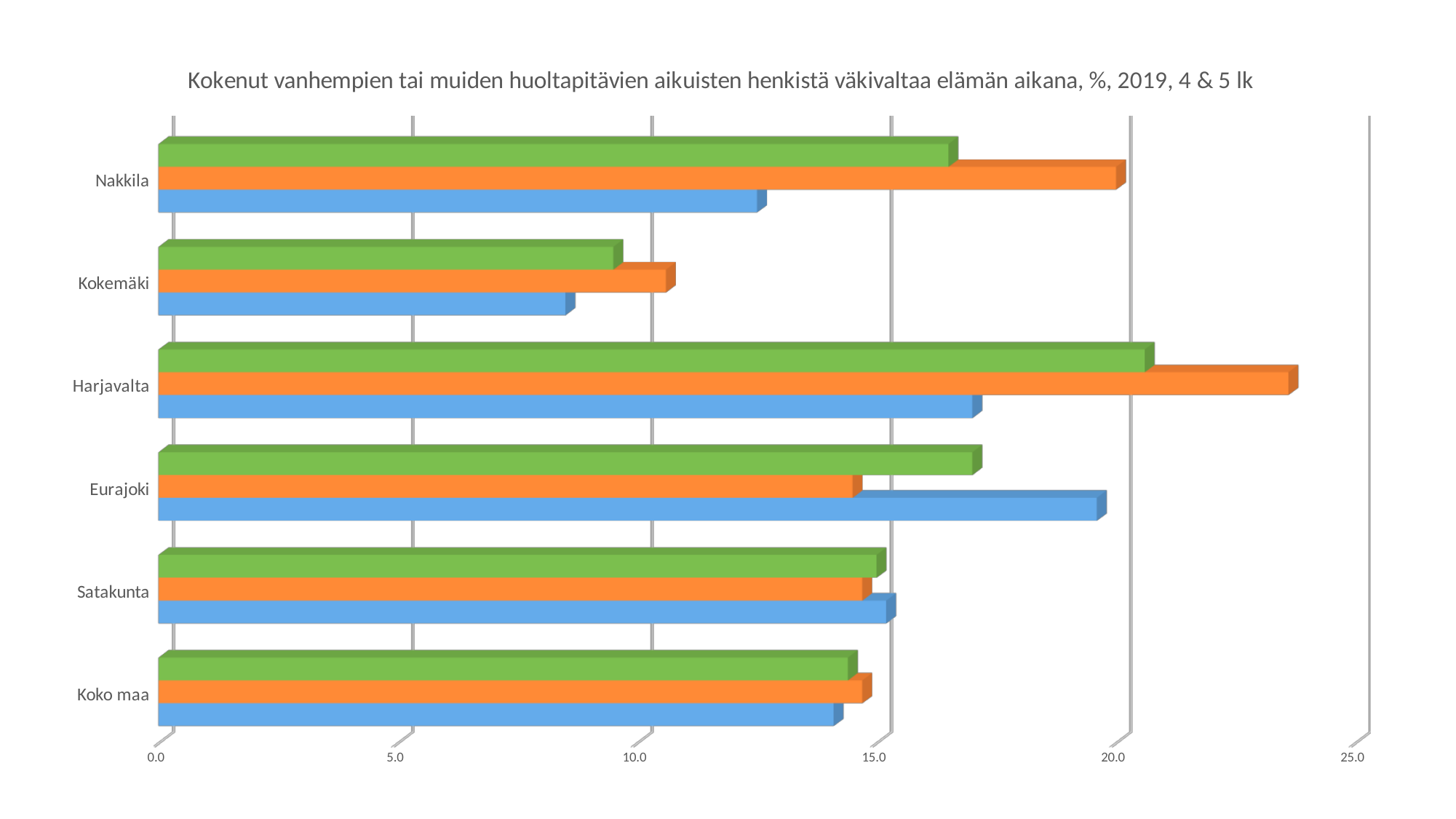
Which category has the longest blue bar? Eurajoki What is the highest value shown on the horizontal axis of the chart? 25.0 Is the value of the blue bar for Nakkila greater or less than 10.0? greater What kind of chart is shown on the slide? bar chart How many bars are plotted for each category in the chart? 3 Is the value of the orange bar for Harjavalta greater or less than 20.0? greater Which category has the shortest green bar? Kokemäki Which category has the longest orange bar? Harjavalta Is the value of the green bar for Kokemäki greater or less than 10.0? less How many categories are shown on the vertical axis of the chart? 6 For Nakkila, which is larger: the orange bar or the blue bar? the orange bar